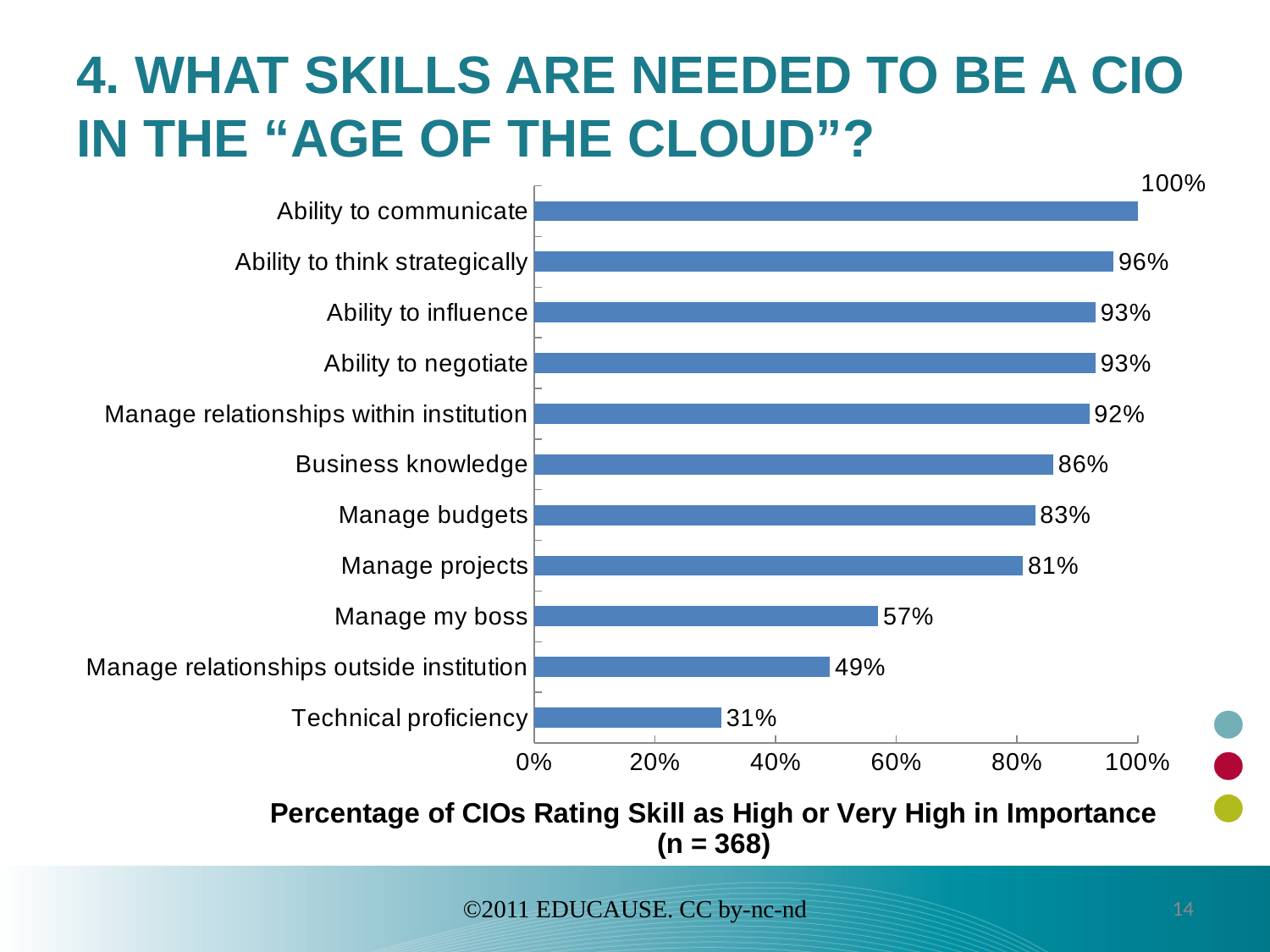
How many skills are listed in the chart? 11 What is the difference between the values for 'Manage budgets' and 'Manage projects'? 2% What is the value for 'Business knowledge'? 86% What kind of chart is shown on the slide? Bar chart Which has a larger value, 'Manage my boss' or 'Manage relationships outside institution'? Manage my boss Which skill has the highest percentage of CIOs rating it as high or very high in importance? Ability to communicate What is the value shown for 'Technical proficiency'? 31% What percentage of CIOs rated 'Ability to communicate' as high or very high in importance? 100% What is the sample size (n) stated below the chart? 368 Which skill has the lowest percentage? Technical proficiency Is the value for 'Manage relationships outside institution' greater or less than 60%? less What percentage is shown for 'Manage my boss'? 57%